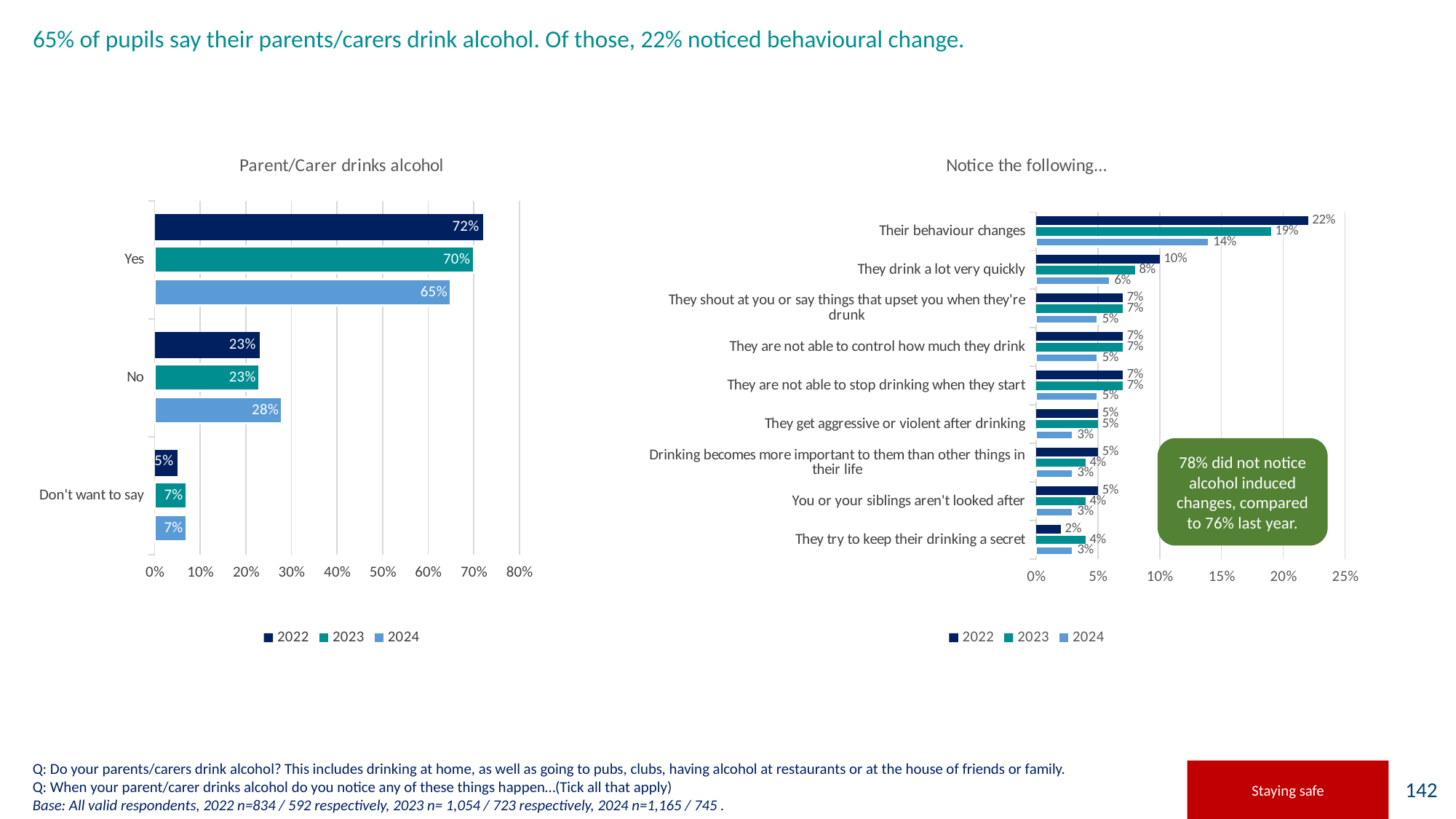
How many categories are shown in the 'Notice the following...' chart? 9 In the 'Notice the following...' chart, which category has the highest 2024 value? Their behaviour changes In the 'Notice the following...' chart, what is the 2023 value for 'Their behaviour changes'? 19% In the 'Parent/Carer drinks alcohol' chart, how many series does the legend list? 3 In the 'Parent/Carer drinks alcohol' chart, what is the value for 'No' in 2022? 23% In the 'Notice the following...' chart, what is the difference between the 2022 and 2024 values for 'They drink a lot very quickly'? 4% In the 'Notice the following...' chart, is the 2022 value for 'They drink a lot very quickly' larger or smaller than the 2022 value for 'They get aggressive or violent after drinking'? larger In the 'Notice the following...' chart, what is the 2022 value for 'They try to keep their drinking a secret'? 2% In the 'Parent/Carer drinks alcohol' chart, which category has the lowest value in 2022? Don't want to say In the 'Parent/Carer drinks alcohol' chart, what is the difference between the 'Yes' values for 2022 and 2024? 7% What type of chart is the 'Parent/Carer drinks alcohol' chart? Bar chart In the 'Parent/Carer drinks alcohol' chart, what is the value for 'Yes' in 2024? 65%